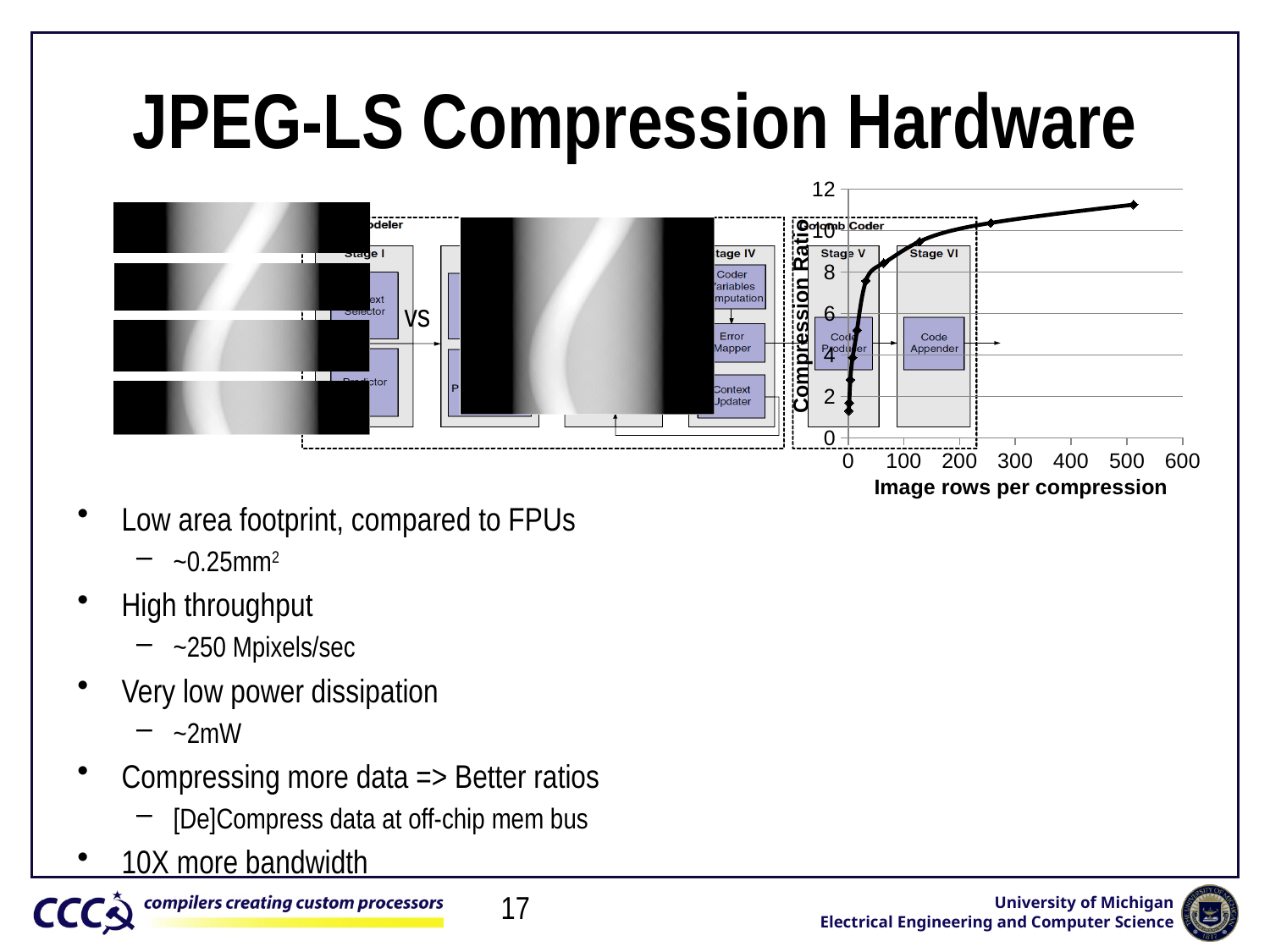
What is the label of the x axis of the chart? Image rows per compression Is the compression ratio at about 500 image rows per compression greater or less than 10? greater What is the highest value shown on the y axis of the chart? 12 Is the compression ratio at about 500 image rows per compression greater or less than 12? less What is the label of the y axis of the chart? Compression Ratio Is the compression ratio at the leftmost point (near 0 image rows) greater or less than 2? less Which has the higher compression ratio: the point near 0 image rows or the point near 500 image rows? the point near 500 image rows Does the compression ratio rise or fall as the number of image rows per compression increases? rise What kind of chart is shown on the right of the slide? line chart